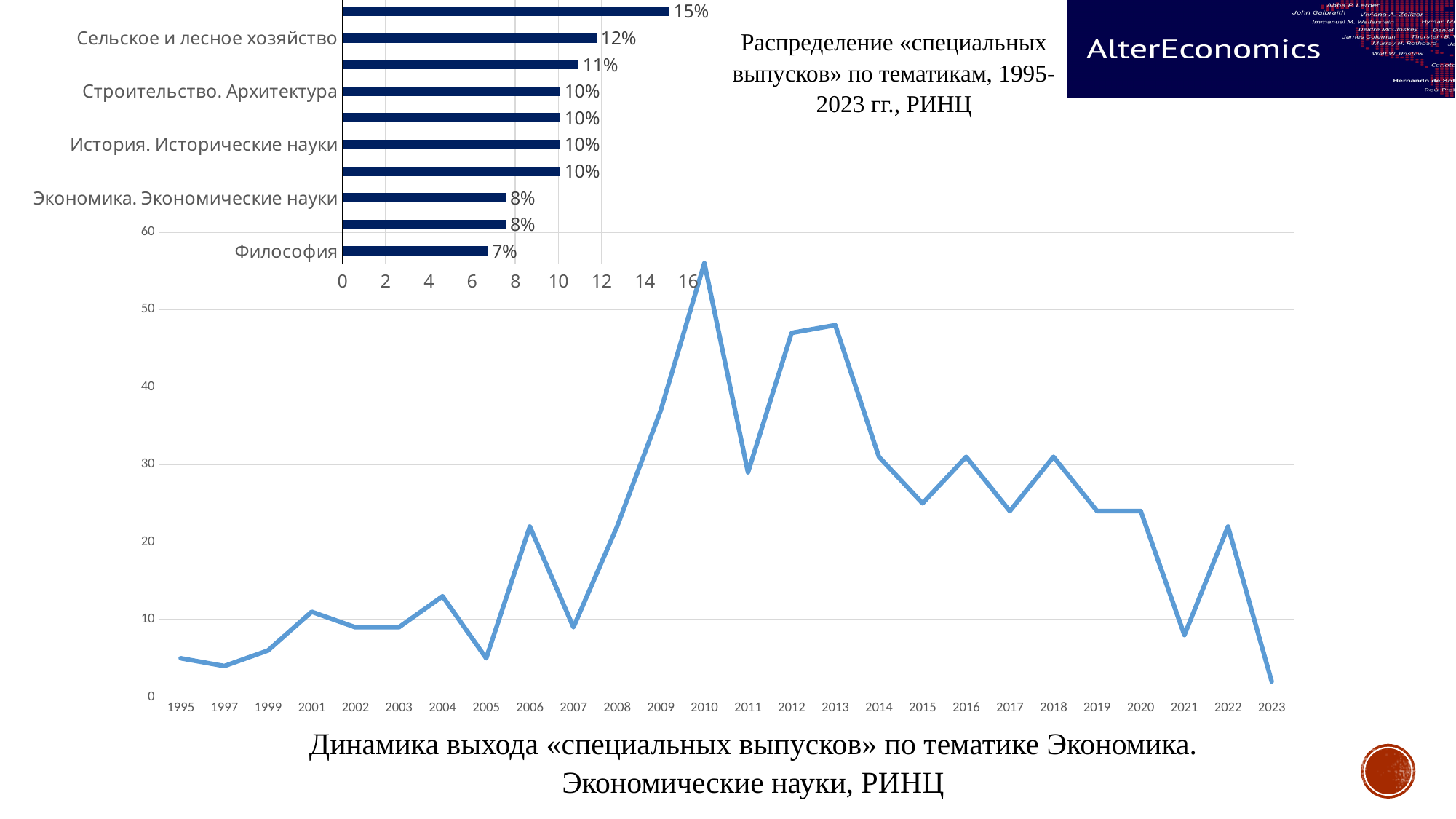
In the line chart titled «Динамика выхода «специальных выпусков» по тематике Экономика. Экономические науки, РИНЦ», do the values rise or fall from 2018 to 2021? fall In the bar chart titled «Распределение «специальных выпусков» по тематикам, 1995-2023 гг., РИНЦ», which is larger: Сельское и лесное хозяйство or История. Исторические науки? Сельское и лесное хозяйство In the bar chart titled «Распределение «специальных выпусков» по тематикам, 1995-2023 гг., РИНЦ», how many bars are plotted? 10 In the line chart titled «Динамика выхода «специальных выпусков» по тематике Экономика. Экономические науки, РИНЦ», which year has the highest value? 2010 In the line chart titled «Динамика выхода «специальных выпусков» по тематике Экономика. Экономические науки, РИНЦ», is the value for 2010 greater or less than 50? greater In the bar chart titled «Распределение «специальных выпусков» по тематикам, 1995-2023 гг., РИНЦ», what is the value for Экономика. Экономические науки? 8% In the bar chart titled «Распределение «специальных выпусков» по тематикам, 1995-2023 гг., РИНЦ», what is the value for Философия? 7% What kind of chart is the chart titled «Динамика выхода «специальных выпусков» по тематике Экономика. Экономические науки, РИНЦ»? line chart In the bar chart titled «Распределение «специальных выпусков» по тематикам, 1995-2023 гг., РИНЦ», what is the difference between Сельское и лесное хозяйство and Философия? 5% In the line chart titled «Динамика выхода «специальных выпусков» по тематике Экономика. Экономические науки, РИНЦ», is the value for 2023 greater or less than 10? less In the bar chart titled «Распределение «специальных выпусков» по тематикам, 1995-2023 гг., РИНЦ», what is the value for Сельское и лесное хозяйство? 12% In the bar chart titled «Распределение «специальных выпусков» по тематикам, 1995-2023 гг., РИНЦ», what is the value for Строительство. Архитектура? 10%